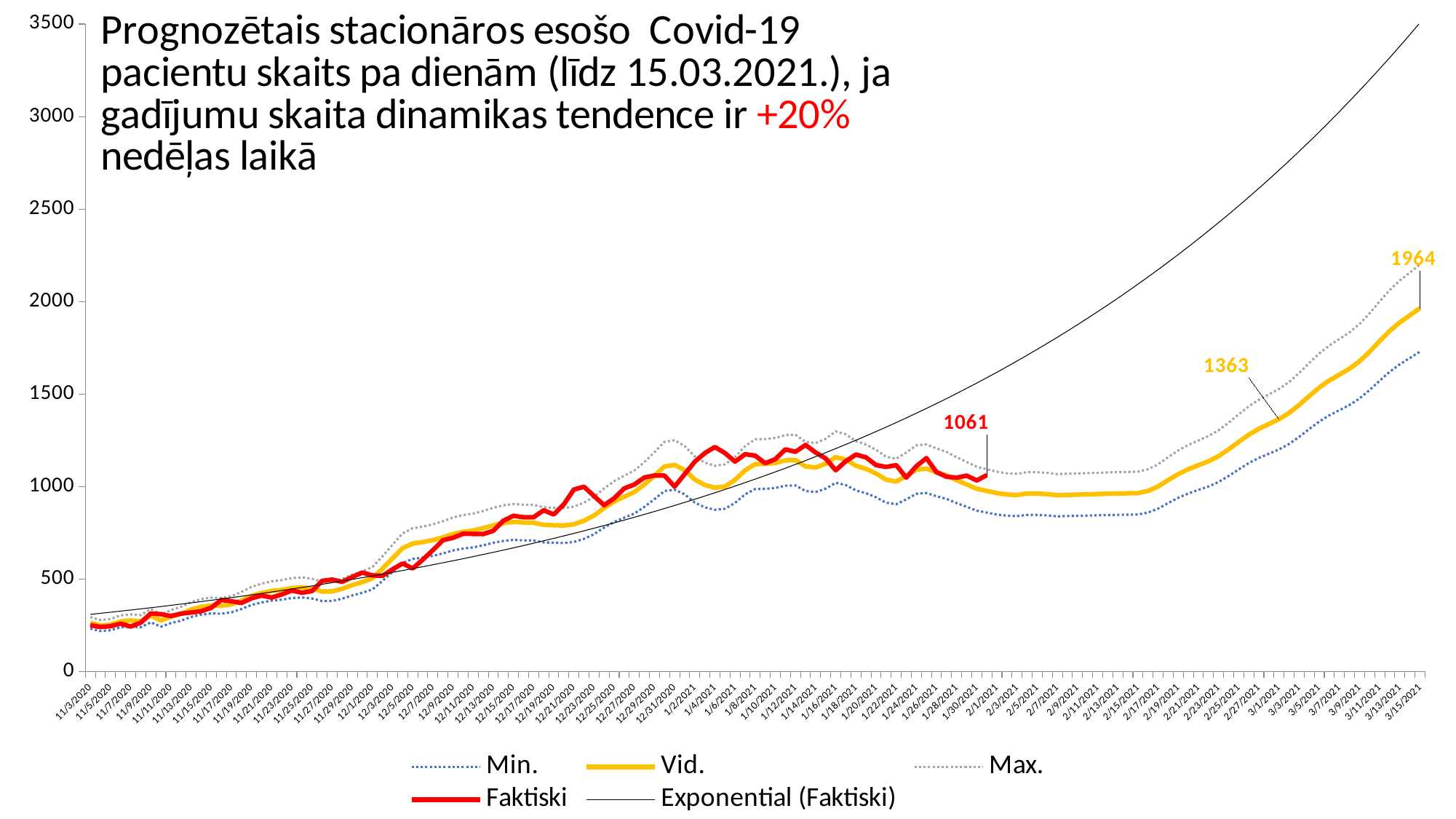
Which series has the highest value on 3/15/2021? Exponential (Faktiski) What is the labelled value of the Vid. series on 3/15/2021? 1964 What kind of chart is shown on the slide? line chart Is the value of the Min. series on 3/15/2021 greater or less than 2000? less What is the last labelled value of the Faktiski series? 1061 What is the difference between the Vid. values labelled 1964 and 1363? 601 Does the Vid. series rise or fall between 2/15/2021 and 3/15/2021? rise Which is larger: the Vid. value on 3/15/2021 or the last labelled Faktiski value? Vid. value on 3/15/2021 What is the difference between the Vid. value labelled 1363 and the Faktiski value labelled 1061? 302 What is the labelled value of the Vid. series on 3/1/2021? 1363 How many series does the legend list? 5 What percentage is highlighted in red in the chart title? +20%